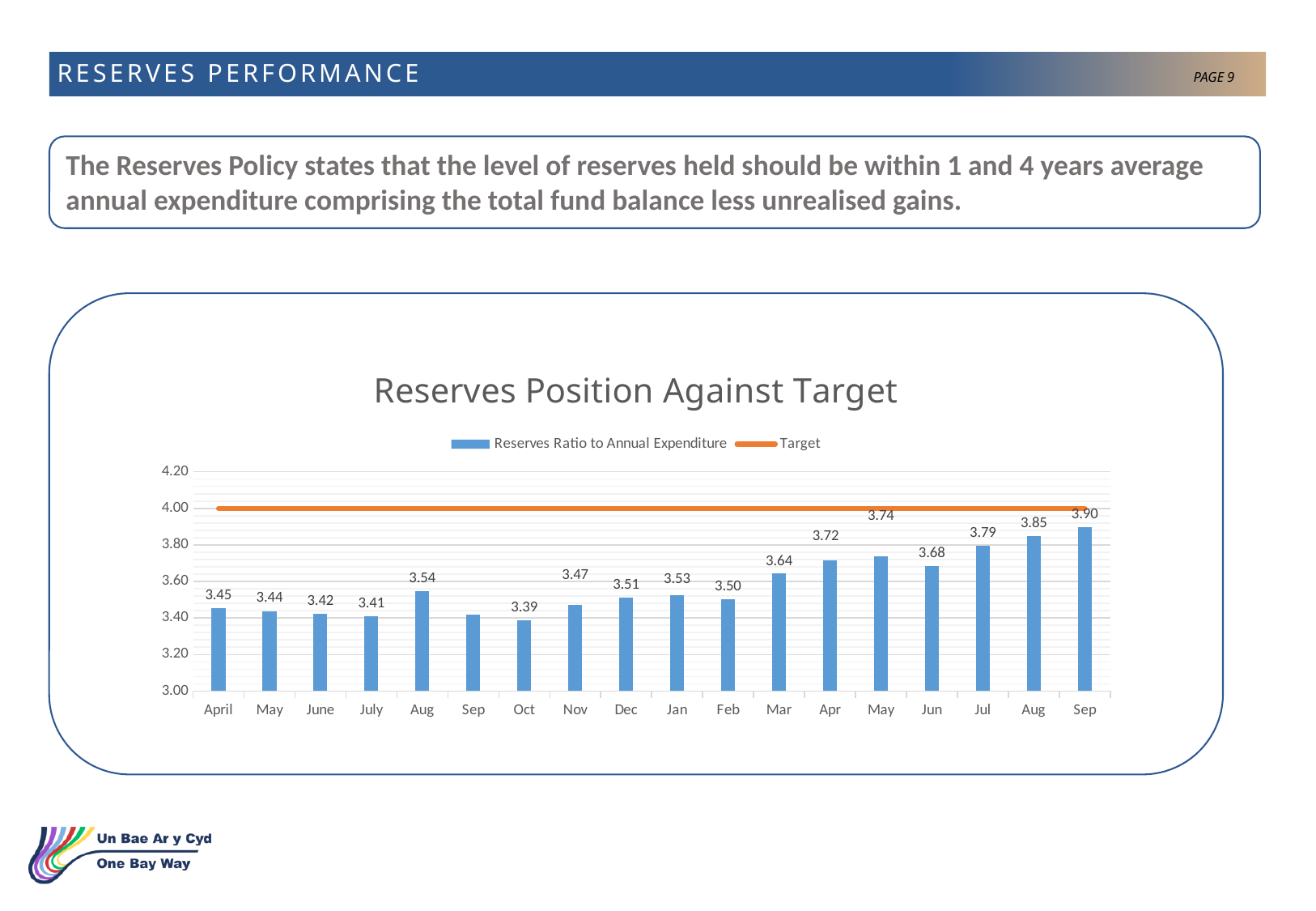
Overall, do the Reserves Ratio bars rise or fall from April to the final Sep? rise What value does the Target line sit at on the axis? 4.00 How many series does the chart legend list? 2 What is the title of the chart? Reserves Position Against Target What is the Reserves Ratio to Annual Expenditure for Oct? 3.39 What is the difference between the Reserves Ratio for the second Aug (3.85) and Jul (3.79)? 0.06 What is the Reserves Ratio to Annual Expenditure for Mar? 3.64 Is the Reserves Ratio for the first Sep bar greater or less than 3.60? less What type of chart is shown on the slide? Bar chart (with a target line) How many months (bars) are plotted on the chart? 18 Which month has the highest Reserves Ratio to Annual Expenditure? The final Sep (3.90) Which is larger, the Reserves Ratio for Nov or for Jan? Jan